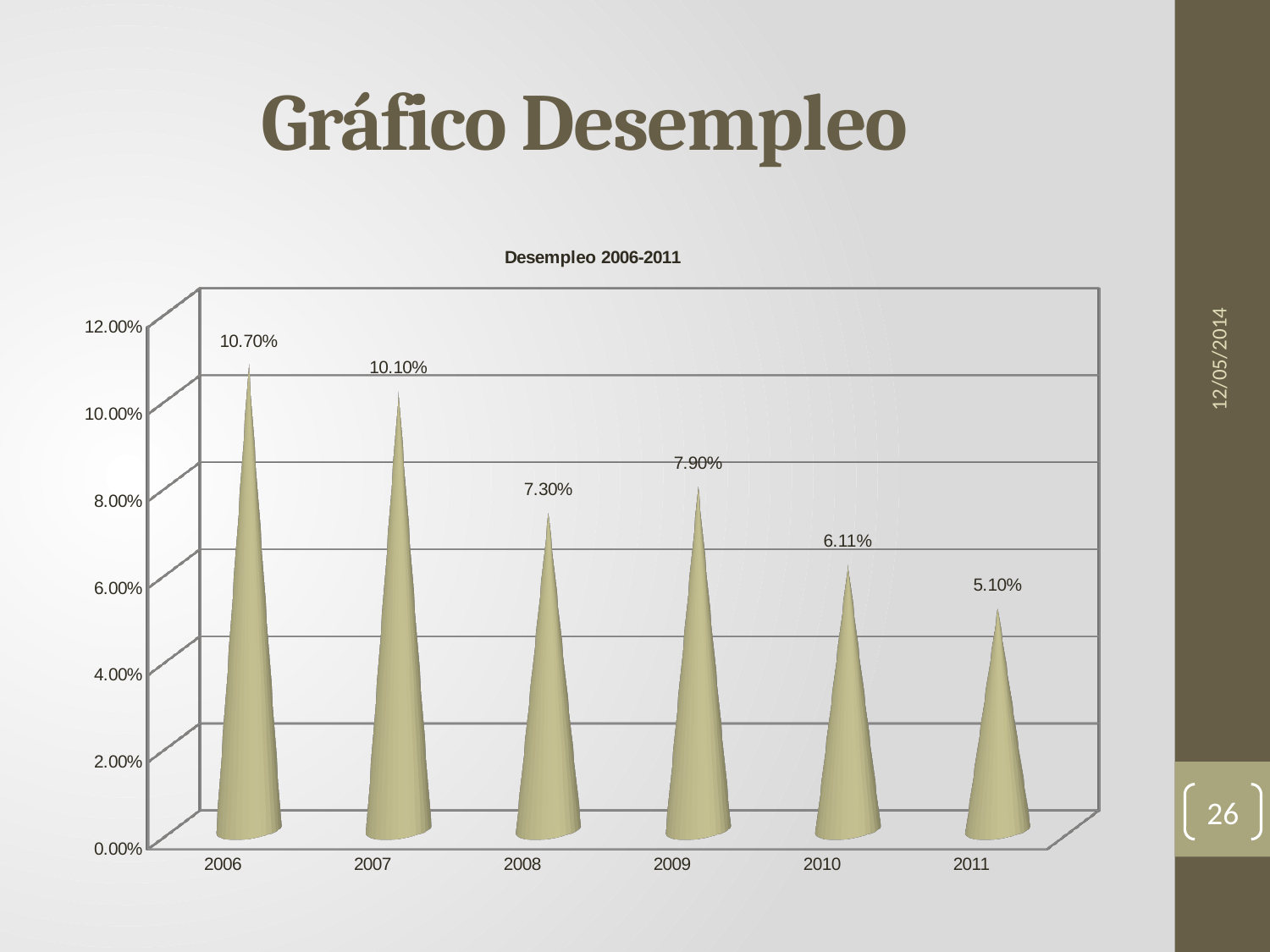
What is the difference between the values for 2008 and 2009? 0.60% Is the value for 2010 greater or less than 8.00%? less What is the unemployment value for 2006? 10.70% What is the title of the chart? Desempleo 2006-2011 What is the difference between the values for 2006 and 2011? 5.60% Which is larger, the value for 2008 or the value for 2009? 2009 What is the value shown for 2009? 7.90% How many years are shown on the x axis? 6 What is the value shown for 2011? 5.10% Which year has the lowest unemployment value? 2011 What kind of chart is shown on the slide? bar chart Which year has the highest unemployment value? 2006